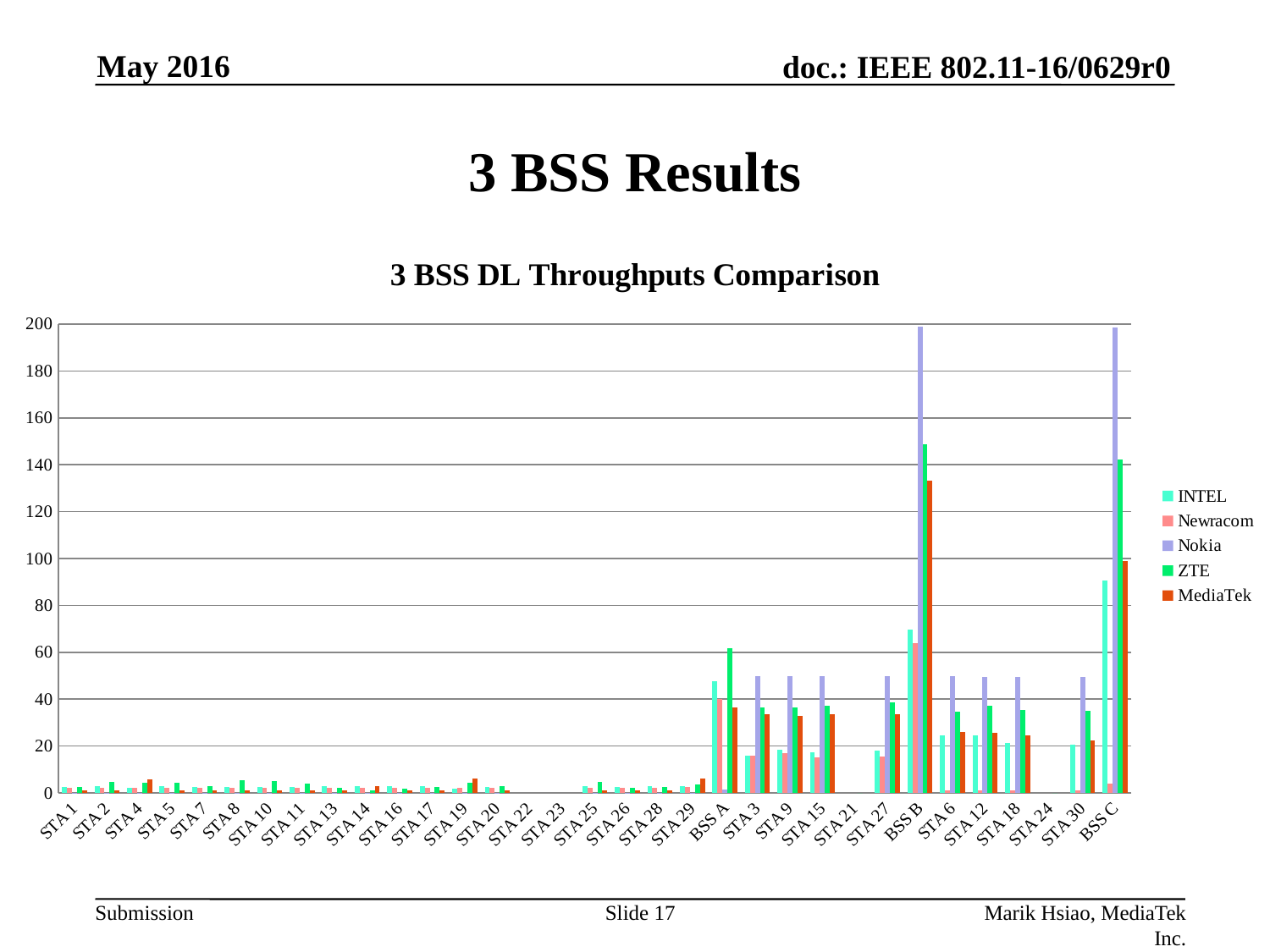
Is the ZTE value for BSS B greater or less than 140? greater Is the INTEL value for BSS C greater or less than 80? greater Is the INTEL value for BSS A greater or less than 40? greater What is the title of the chart? 3 BSS DL Throughputs Comparison Which series has the highest value for BSS B? Nokia For BSS C, which is larger: the INTEL value or the Newracom value? INTEL How many series does the legend list? 5 What kind of chart is shown on the slide? bar chart Which series is shown in red in the legend? MediaTek